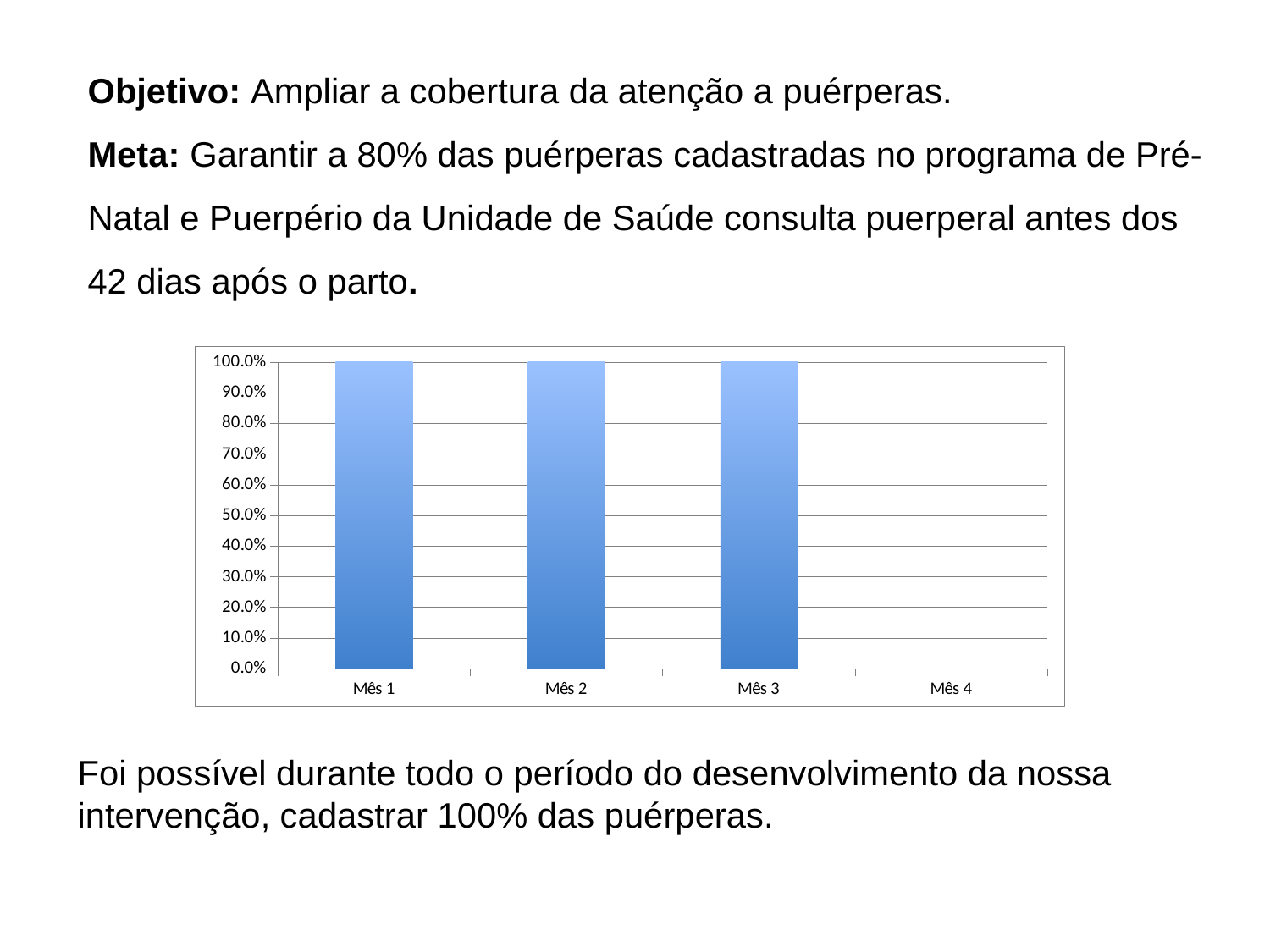
Is the value for Mês 4 greater or less than 10.0%? less What kind of chart is shown on the slide? bar chart How many categories are shown on the x axis of the chart? 4 What is the value for Mês 2 in the chart? 100.0% What is the difference between the values for Mês 1 and Mês 2? 0.0% Is the value for Mês 2 greater or less than 80.0%? greater Which is larger, the value for Mês 3 or the value for Mês 4? Mês 3 What is the value for Mês 1 in the chart? 100.0% What is the highest value shown on the y axis of the chart? 100.0% Which category has the lowest value in the chart? Mês 4 What is the label of the first category on the x axis? Mês 1 What is the value for Mês 3 in the chart? 100.0%